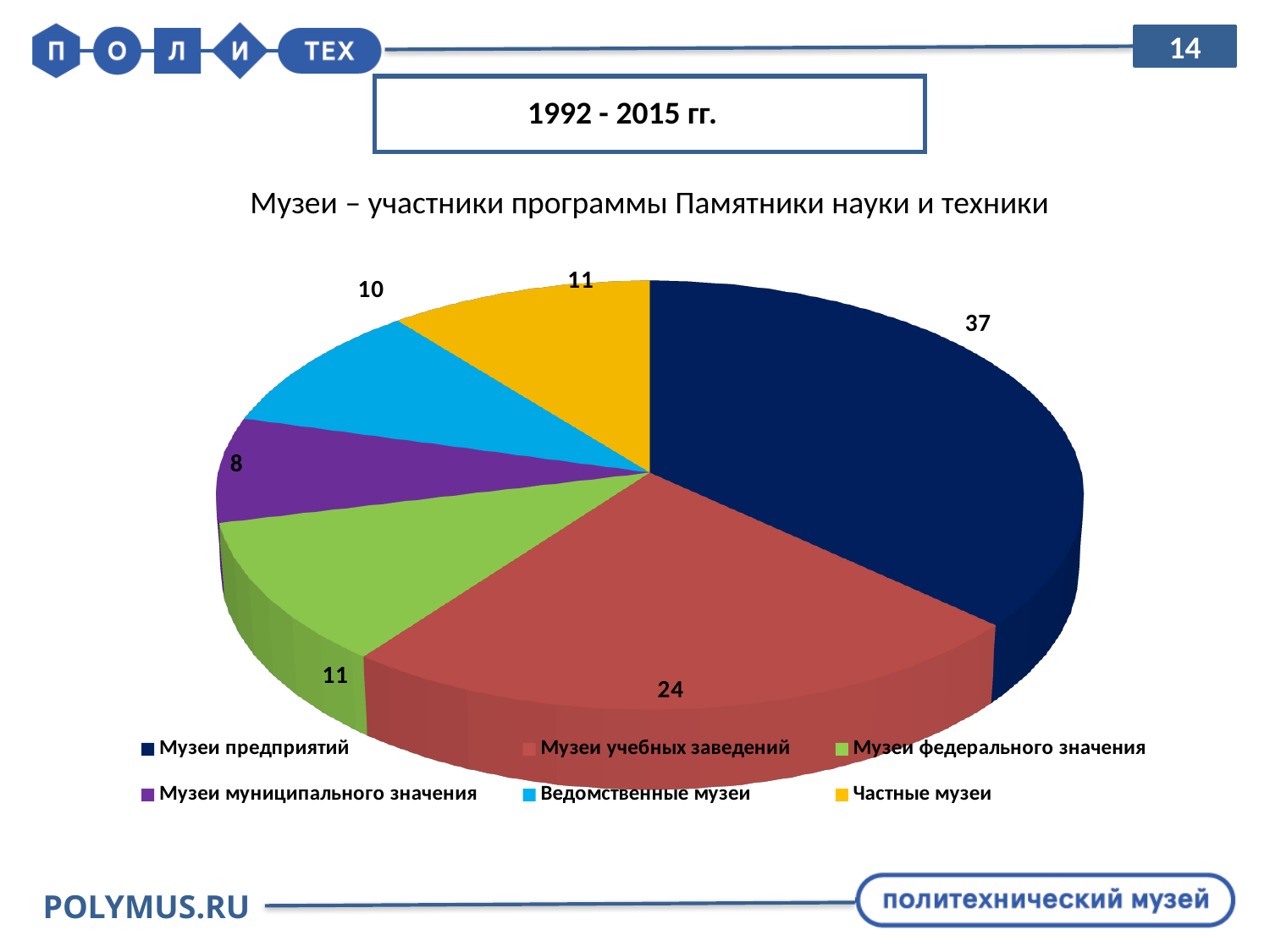
What colour is the slice for Частные музеи? Yellow Which category has the largest slice of the pie? Музеи предприятий What is the title of the chart? Музеи – участники программы Памятники науки и техники What is the value for Ведомственные музеи? 10 How many categories does the pie chart have? 6 What is the value for Музеи учебных заведений? 24 What is the value for Музеи муниципального значения? 8 Which is larger, the value for Музеи федерального значения or the value for Музеи муниципального значения? Музеи федерального значения What is the value for Музеи предприятий? 37 Which category has the smallest slice of the pie? Музеи муниципального значения What type of chart is shown on the slide? Pie chart What is the difference between the values for Музеи предприятий and Музеи учебных заведений? 13